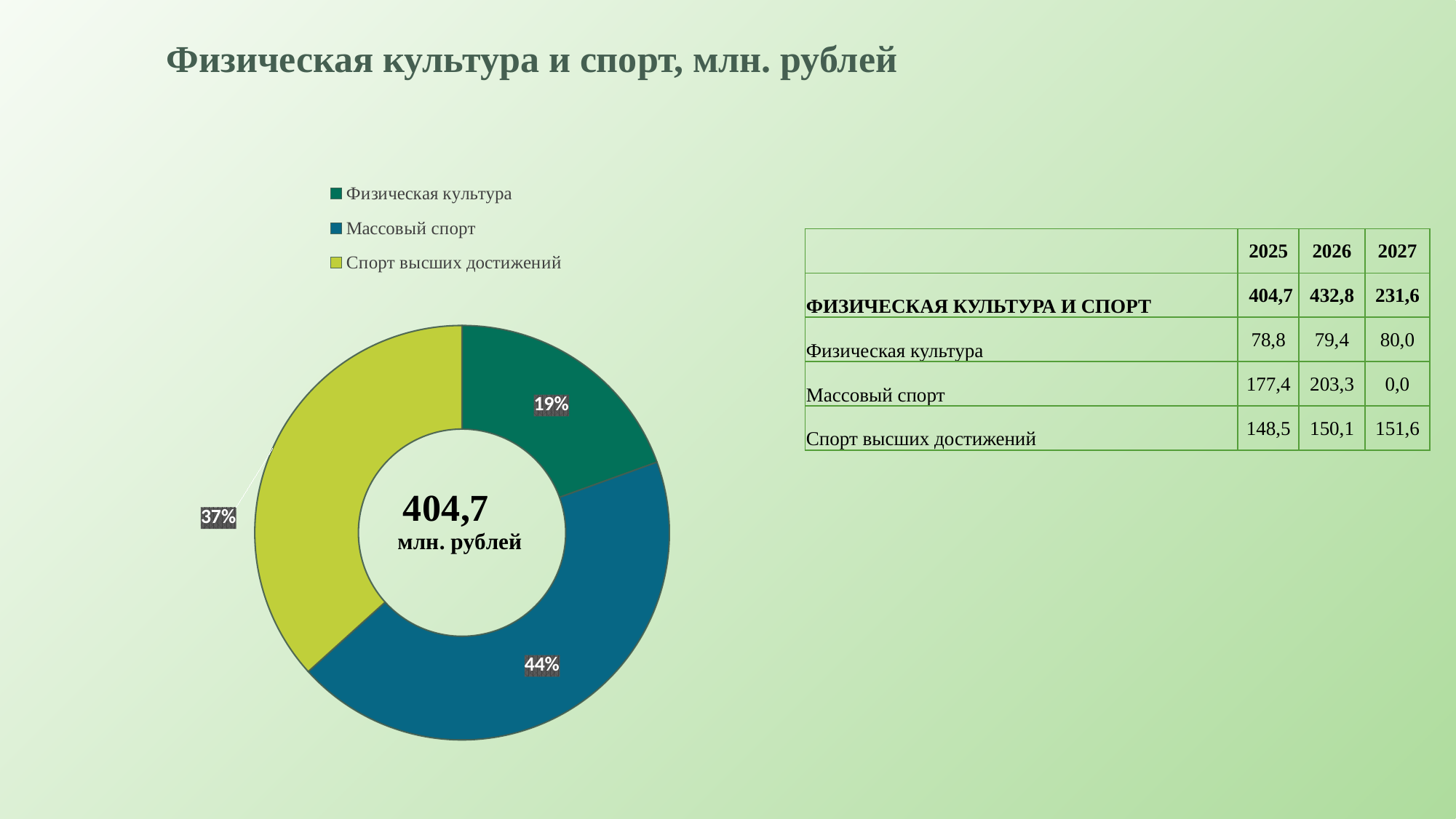
How many entries does the legend of the doughnut chart list? 3 Which slice is larger in the doughnut chart: Массовый спорт or Спорт высших достижений? Массовый спорт By how many percentage points does the Массовый спорт slice exceed the Физическая культура slice? 25 percentage points Which category has the largest slice in the doughnut chart? Массовый спорт How many slices does the doughnut chart have? 3 What share of the doughnut chart does Спорт высших достижений take? 37% What share of the doughnut chart does Массовый спорт take? 44% What share of the doughnut chart does Физическая культура take? 19% What total value is printed in the centre of the doughnut chart? 404,7 млн. рублей Which category has the smallest slice in the doughnut chart? Физическая культура What colour is the Спорт высших достижений slice in the doughnut chart? yellow-green What kind of chart is shown on the slide? doughnut chart